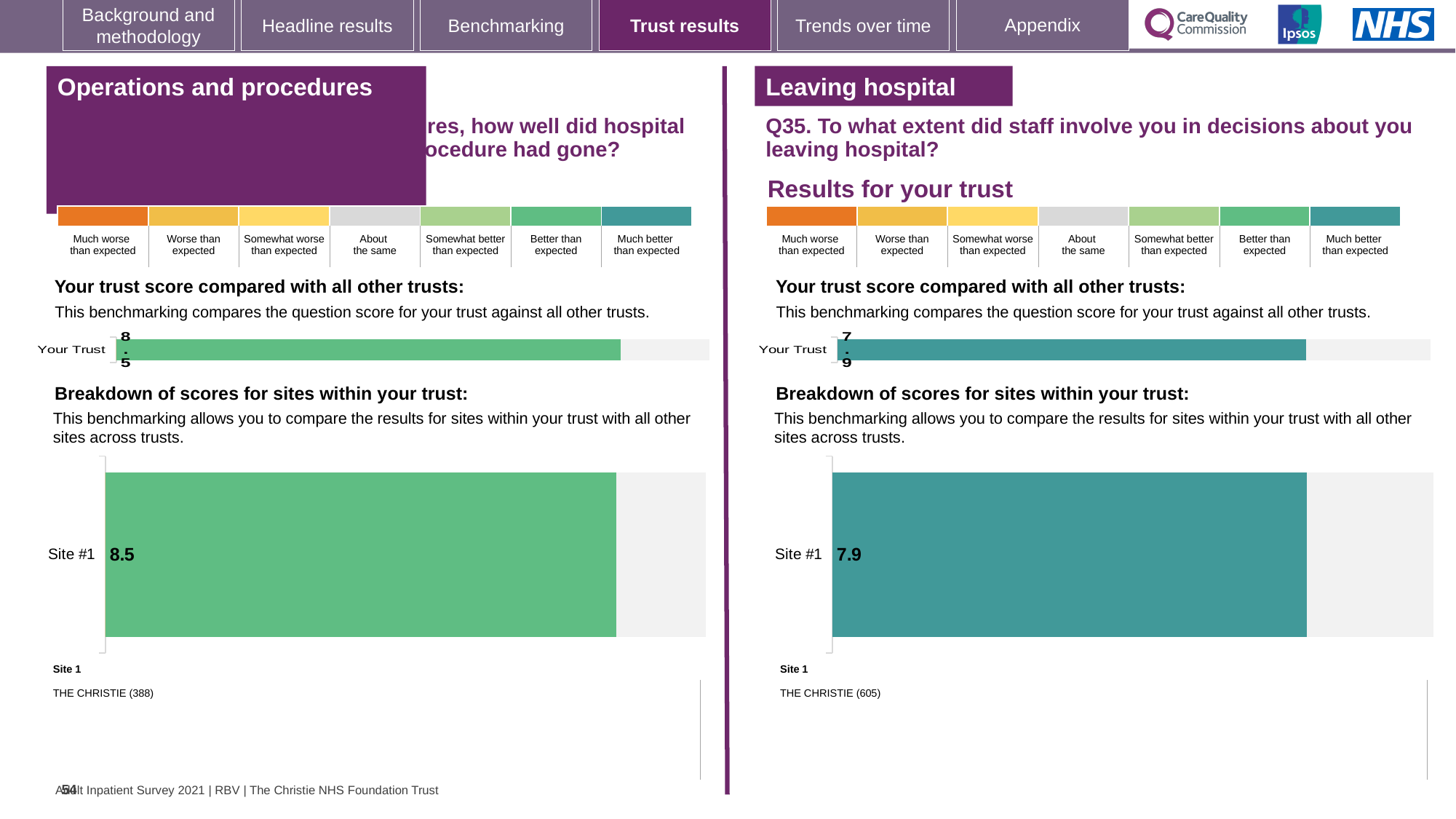
What is the difference between the Site #1 score in the 'Operations and procedures' breakdown chart and the Site #1 score in the 'Leaving hospital' breakdown chart? 0.6 On the left-hand 'Operations and procedures' section, what is the 'Your Trust' score in the trust score comparison chart? 8.5 How many sites are shown in the breakdown of scores for sites chart in the 'Operations and procedures' section? 1 What is the name of the site labelled Site 1 in the 'Operations and procedures' section? THE CHRISTIE (388) What is the name of the site labelled Site 1 in the 'Leaving hospital' section? THE CHRISTIE (605) Which Site #1 score is larger: the one in the 'Operations and procedures' breakdown chart or the one in the 'Leaving hospital' breakdown chart? Operations and procedures On the left-hand 'Operations and procedures' section, what is the score shown for Site #1 in the breakdown of scores for sites chart? 8.5 On the right-hand 'Leaving hospital' section, what is the 'Your Trust' score in the trust score comparison chart? 7.9 How many sites are shown in the breakdown of scores for sites chart in the 'Leaving hospital' section? 1 On the right-hand 'Leaving hospital' section, what is the score shown for Site #1 in the breakdown of scores for sites chart? 7.9 What kind of chart is used for the breakdown of scores for sites in the 'Leaving hospital' section? Bar chart